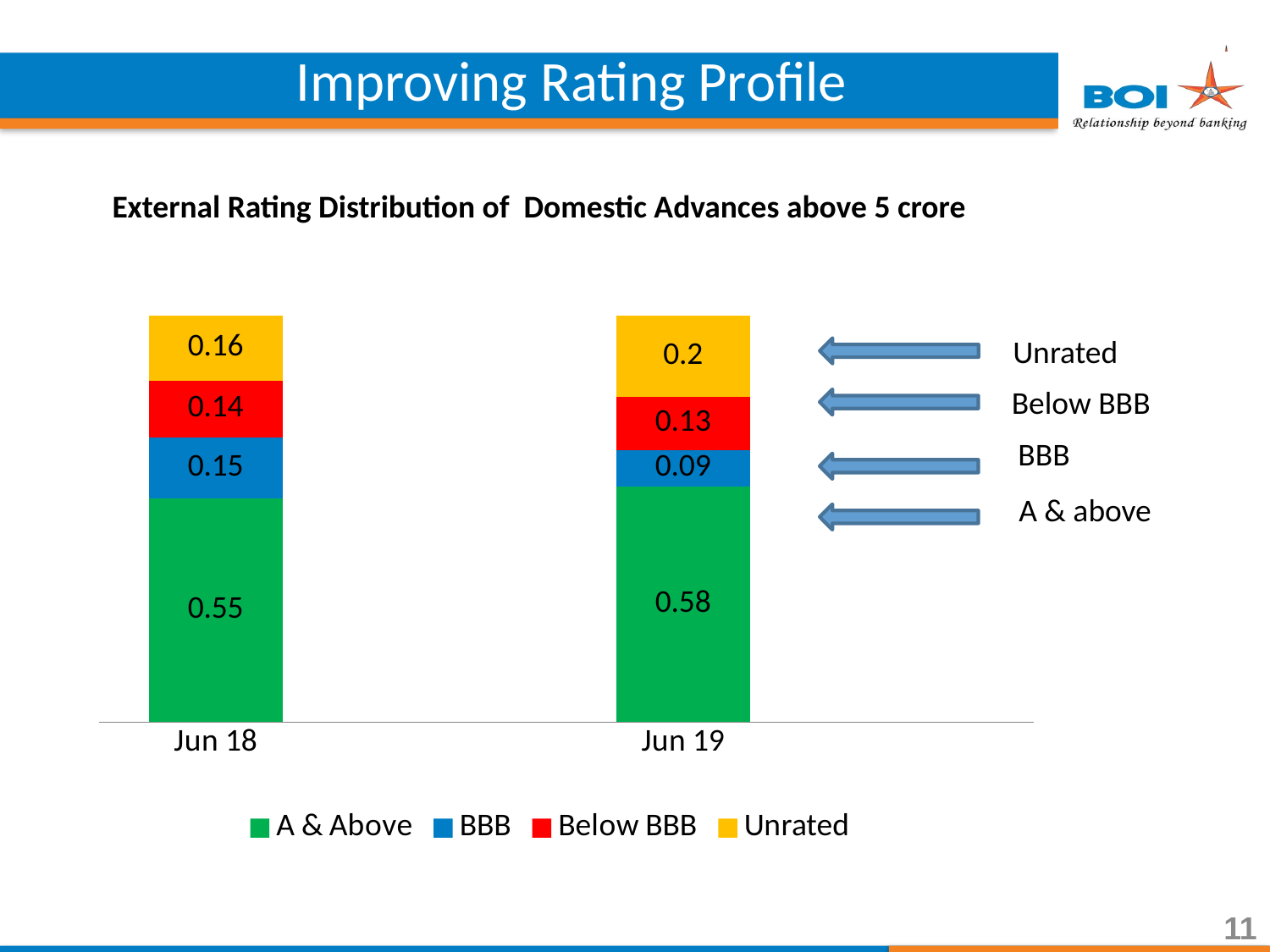
Which is larger, the BBB value for Jun 18 or for Jun 19? Jun 18 What is the value for Below BBB in Jun 18? 0.14 How many categories are shown on the x axis? 2 Which series has the largest value in Jun 19? A & Above What is the value for A & Above in Jun 18? 0.55 How many series does the legend list? 4 Which series has the smallest value in Jun 19? BBB What is the difference between the A & Above values for Jun 19 and Jun 18? 0.03 What is the total of the stacked bar for Jun 18? 1 What kind of chart is shown on the slide? Stacked bar chart What is the value for BBB in Jun 19? 0.09 What is the value for Unrated in Jun 19? 0.2